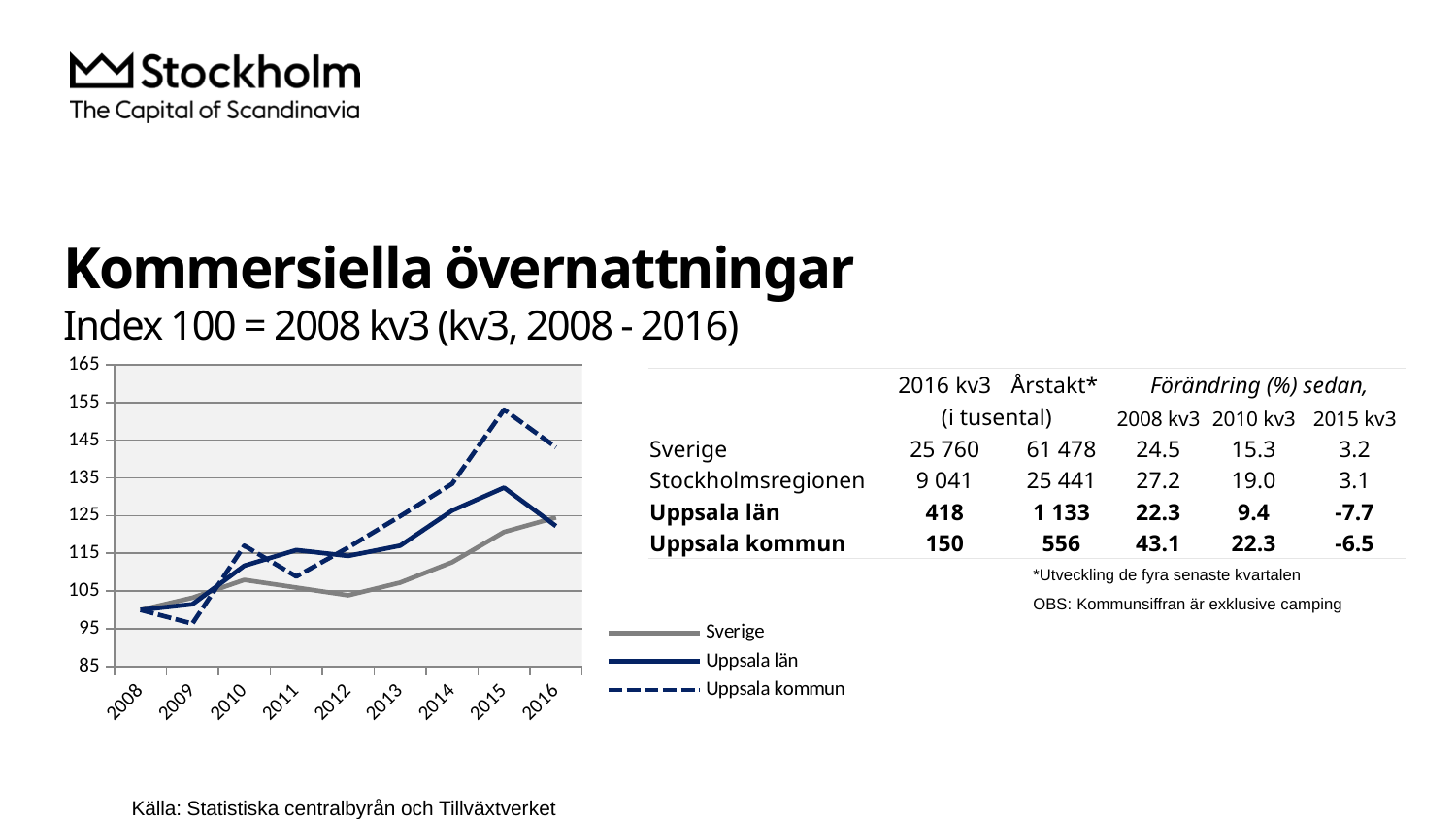
How many series does the chart's legend list? 3 Is the value for Uppsala kommun in 2015 greater or less than 145? greater Is the value for Uppsala län in 2015 greater or less than 125? greater Is the value for Uppsala kommun in 2009 greater or less than 105? less Which series has the lowest value in 2015 in the chart? Sverige Which series has the highest value in 2015 in the chart? Uppsala kommun Which series is drawn with a dashed line in the chart? Uppsala kommun What kind of chart is shown on the slide? line chart Does the Uppsala kommun line rise or fall from 2015 to 2016? fall How many years are shown along the x axis of the chart? 9 Does the Sverige line rise or fall from 2012 to 2016? rise